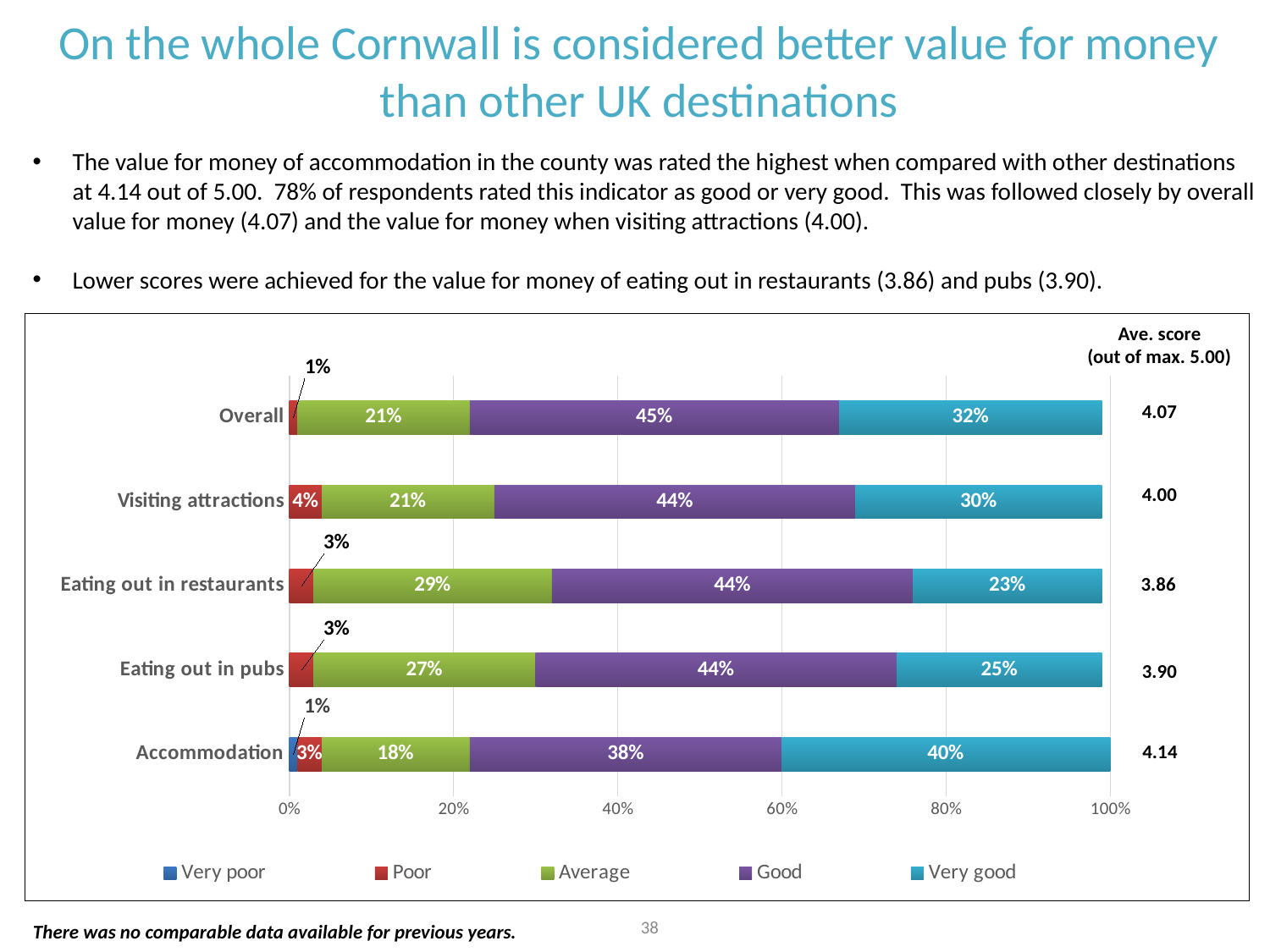
Which has a larger 'Good' percentage: Overall or Accommodation? Overall What percentage of respondents rated Accommodation as 'Very good' for value for money? 40% Which category has the lowest 'Very good' percentage? Eating out in restaurants What is the average score (out of max. 5.00) shown for Eating out in pubs? 3.90 What is the 'Poor' percentage for Visiting attractions? 4% How many series does the legend list? 5 Which category has the highest average score? Accommodation What type of chart is shown on the slide? Stacked bar chart Which category has the highest 'Very good' percentage? Accommodation What is the 'Good' percentage for the Overall bar? 45% How many percentage points higher is the 'Average' share for Eating out in restaurants than for Accommodation? 11 percentage points How many categories are shown on the chart? 5